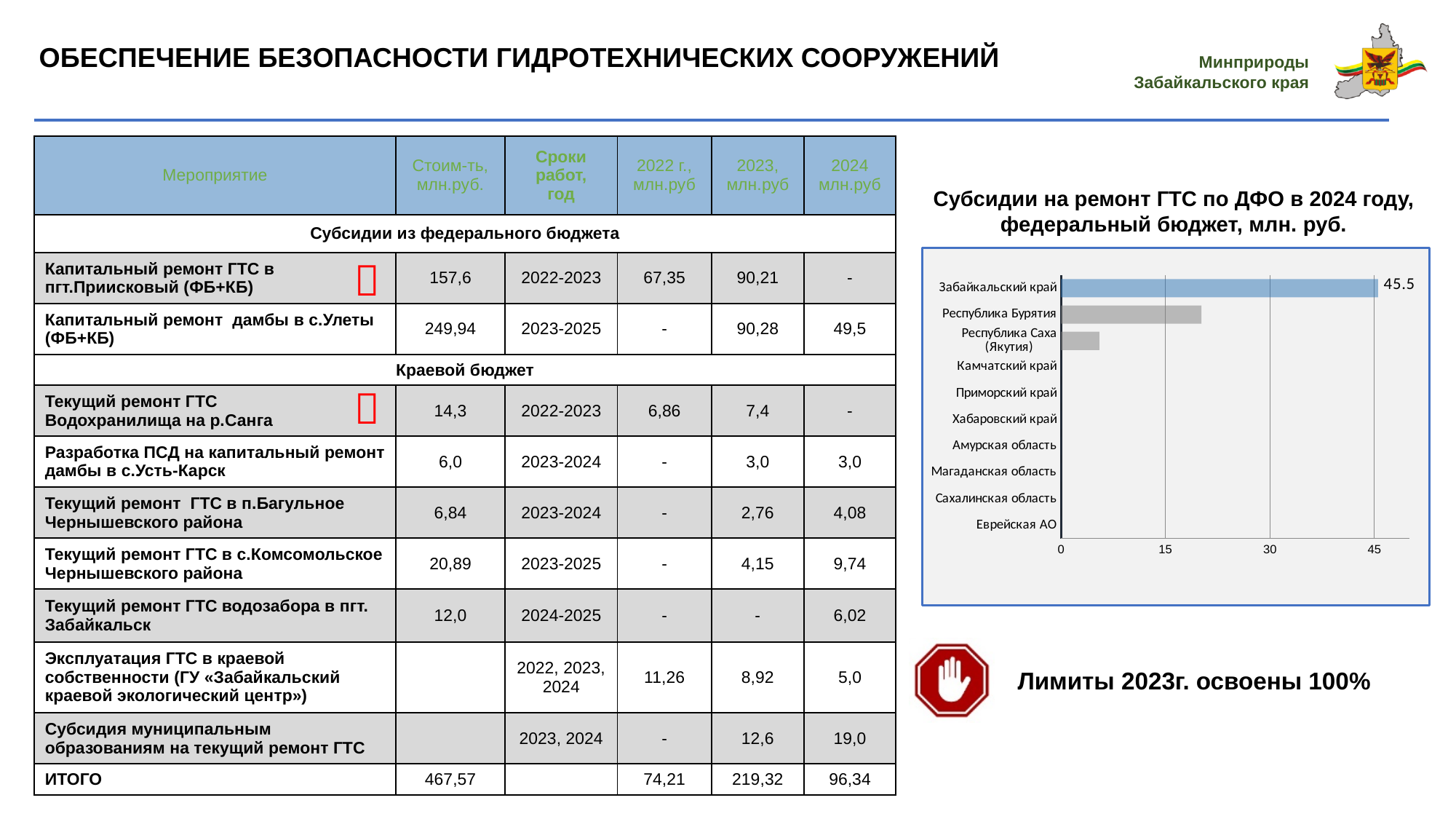
What is the value for Забайкальский край in the chart? 45.5 What is the title of the chart? Субсидии на ремонт ГТС по ДФО в 2024 году, федеральный бюджет, млн. руб. Which has a larger value, Республика Бурятия or Республика Саха (Якутия)? Республика Бурятия Is the value for Республика Саха (Якутия) greater or less than 15? less What is the highest tick value shown on the chart's horizontal axis? 45 Which region has the highest value in the chart? Забайкальский край Which has a larger value, Забайкальский край or Республика Бурятия? Забайкальский край Is the value for Республика Бурятия greater or less than 15? greater Is the value for Республика Бурятия greater or less than 30? less What kind of chart is shown on the slide? bar chart How many regions are listed on the chart's axis? 10